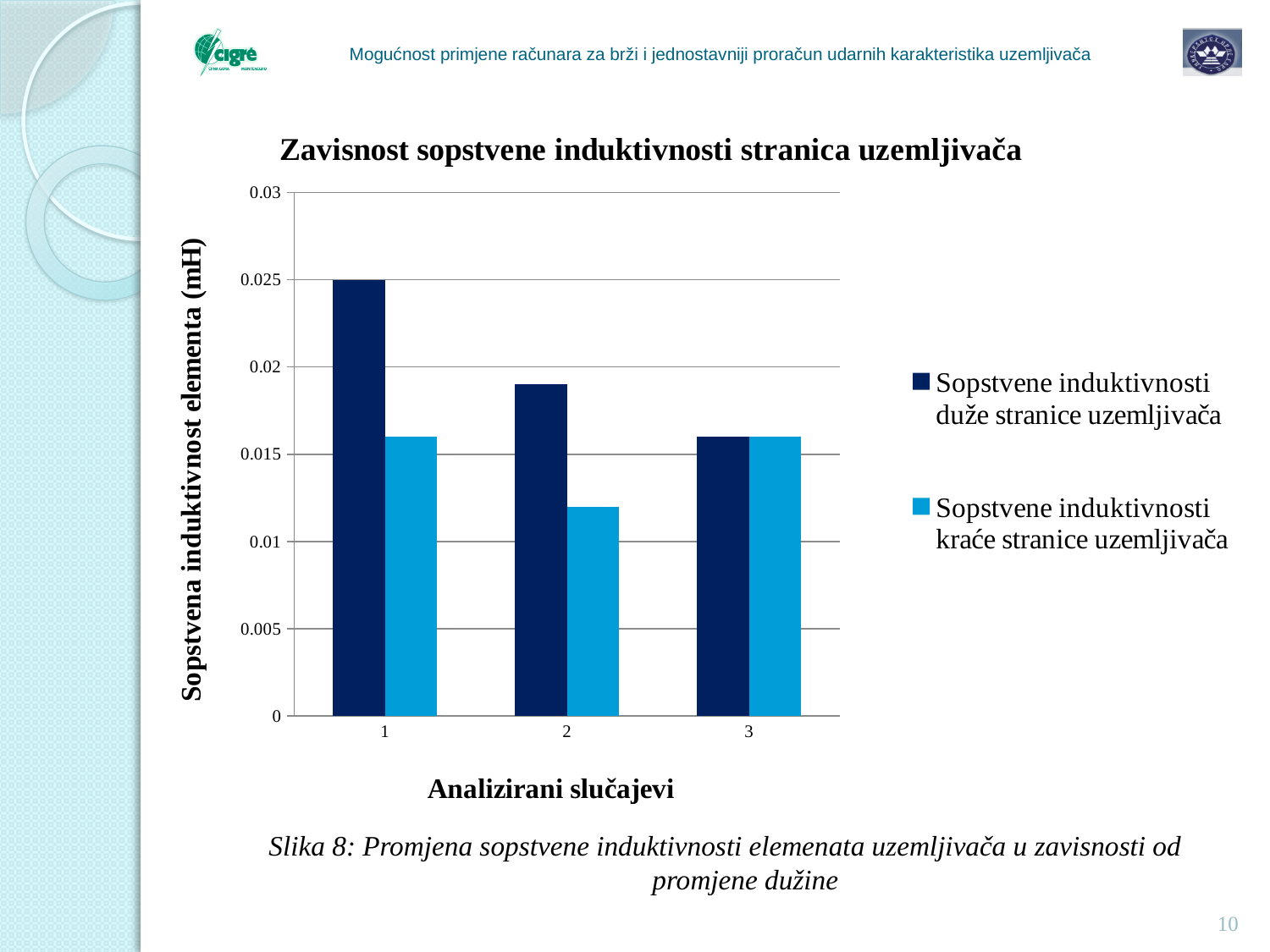
What is the title of the chart? Zavisnost sopstvene induktivnosti stranica uzemljivača Do the values for 'Sopstvene induktivnosti duže stranice uzemljivača' rise or fall from case 1 to case 3? fall Is the value for 'Sopstvene induktivnosti duže stranice uzemljivača' in case 2 greater or less than 0.015? greater For which case is 'Sopstvene induktivnosti kraće stranice uzemljivača' lowest? 2 How many series does the legend list? 2 For case 1, which is larger: the inductance of the longer side (duže stranice) or the shorter side (kraće stranice)? duže stranice How many analysed cases (categories) are shown on the x axis? 3 For which case is 'Sopstvene induktivnosti duže stranice uzemljivača' highest? 1 What type of chart is shown on the slide? bar chart Is the value for 'Sopstvene induktivnosti kraće stranice uzemljivača' in case 2 greater or less than 0.015? less Is the value for 'Sopstvene induktivnosti duže stranice uzemljivača' in case 3 greater or less than 0.02? less What is the value of 'Sopstvene induktivnosti duže stranice uzemljivača' for case 1? 0.025